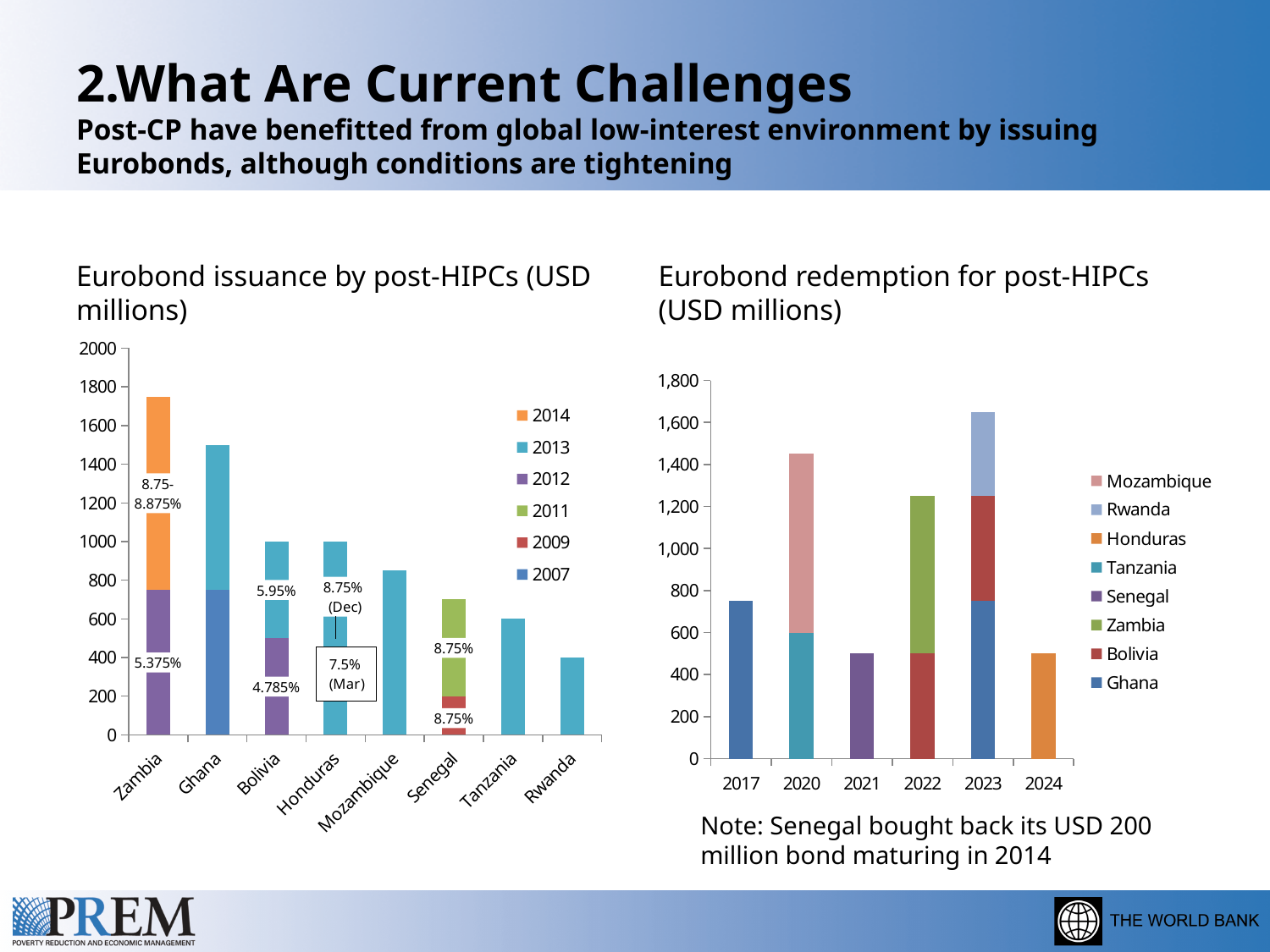
How many countries does the legend of the 'Eurobond redemption for post-HIPCs (USD millions)' chart list? 8 In the 'Eurobond issuance by post-HIPCs' chart, which has the larger total issuance, Ghana or Bolivia? Ghana How many countries are shown on the x axis of the 'Eurobond issuance by post-HIPCs' chart? 8 How many years does the legend of the 'Eurobond issuance by post-HIPCs' chart list? 6 In the 'Eurobond redemption for post-HIPCs' chart, which country's bond is shown as maturing in 2024? Honduras In the 'Eurobond redemption for post-HIPCs' chart, is the total redemption for 2020 greater or less than 1,400? greater In the 'Eurobond issuance by post-HIPCs' chart, which country has the lowest total issuance? Rwanda In the 'Eurobond issuance by post-HIPCs' chart, is the total issuance for Mozambique greater or less than 800? greater In the 'Eurobond issuance by post-HIPCs' chart, what is the total issuance for Honduras? 1000 What kind of chart is the 'Eurobond issuance by post-HIPCs (USD millions)' chart? Stacked bar chart In the 'Eurobond redemption for post-HIPCs' chart, which year has the highest total redemption? 2023 In the 'Eurobond issuance by post-HIPCs' chart, which country has the highest total issuance? Zambia